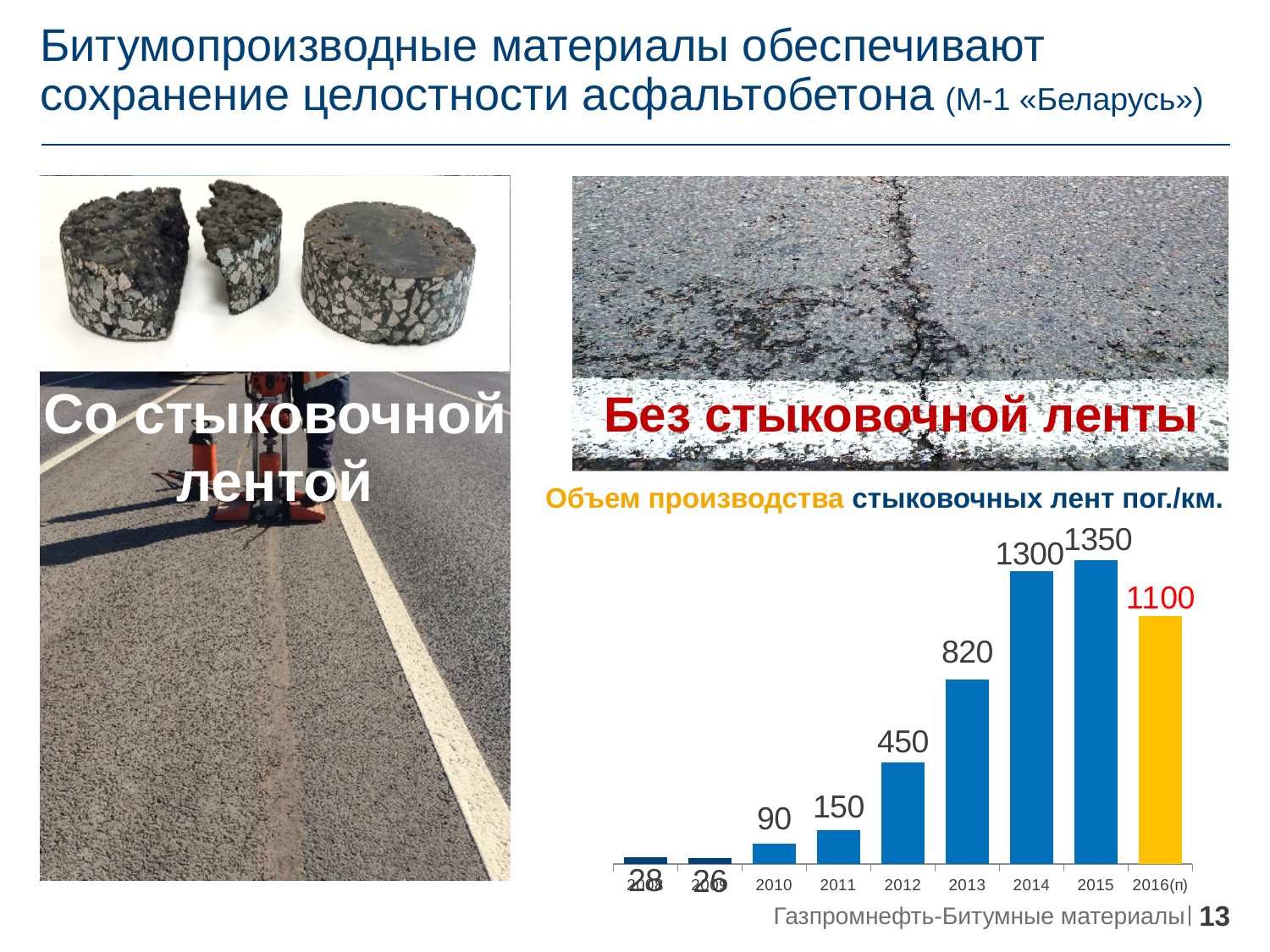
Which year has the highest value in the chart? 2015 What type of chart is shown on the slide? bar chart Which is larger, the value for 2014 or the value for 2016(п)? 2014 Which bar in the chart is coloured yellow instead of blue? 2016(п) What is the difference between the values for 2013 and 2012? 370 What is the difference between the values for 2015 and 2014? 50 Do the values rise or fall from 2010 to 2015? rise What is the production volume of joint tapes for 2015? 1350 What is the value shown for 2012? 450 What is the value shown for 2016(п)? 1100 How many bars are plotted in the chart? 9 What is the value shown for 2013? 820